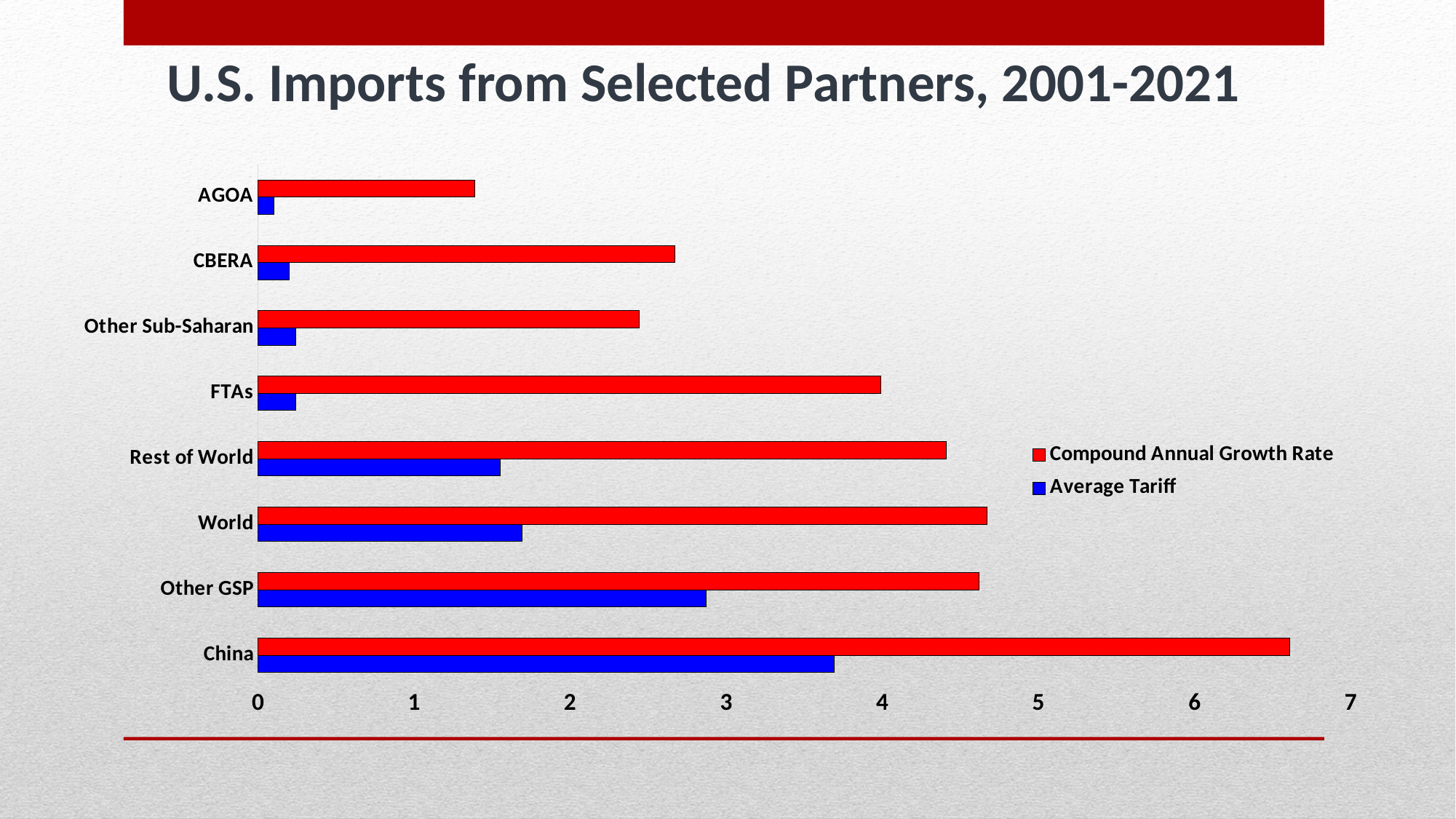
Is the Compound Annual Growth Rate for CBERA greater or less than 3? less Which category has the highest Average Tariff? China How many series does the legend list? 2 Is the Average Tariff for Rest of World greater or less than 1? greater Which has the larger Compound Annual Growth Rate, CBERA or Other Sub-Saharan? CBERA What colour are the Average Tariff bars? blue What kind of chart is shown on the slide? bar chart Which category has the highest Compound Annual Growth Rate? China How many partner categories are plotted on the chart? 8 Which category has the lowest Average Tariff? AGOA Is the Compound Annual Growth Rate for China greater or less than 6? greater Which category has the lowest Compound Annual Growth Rate? AGOA